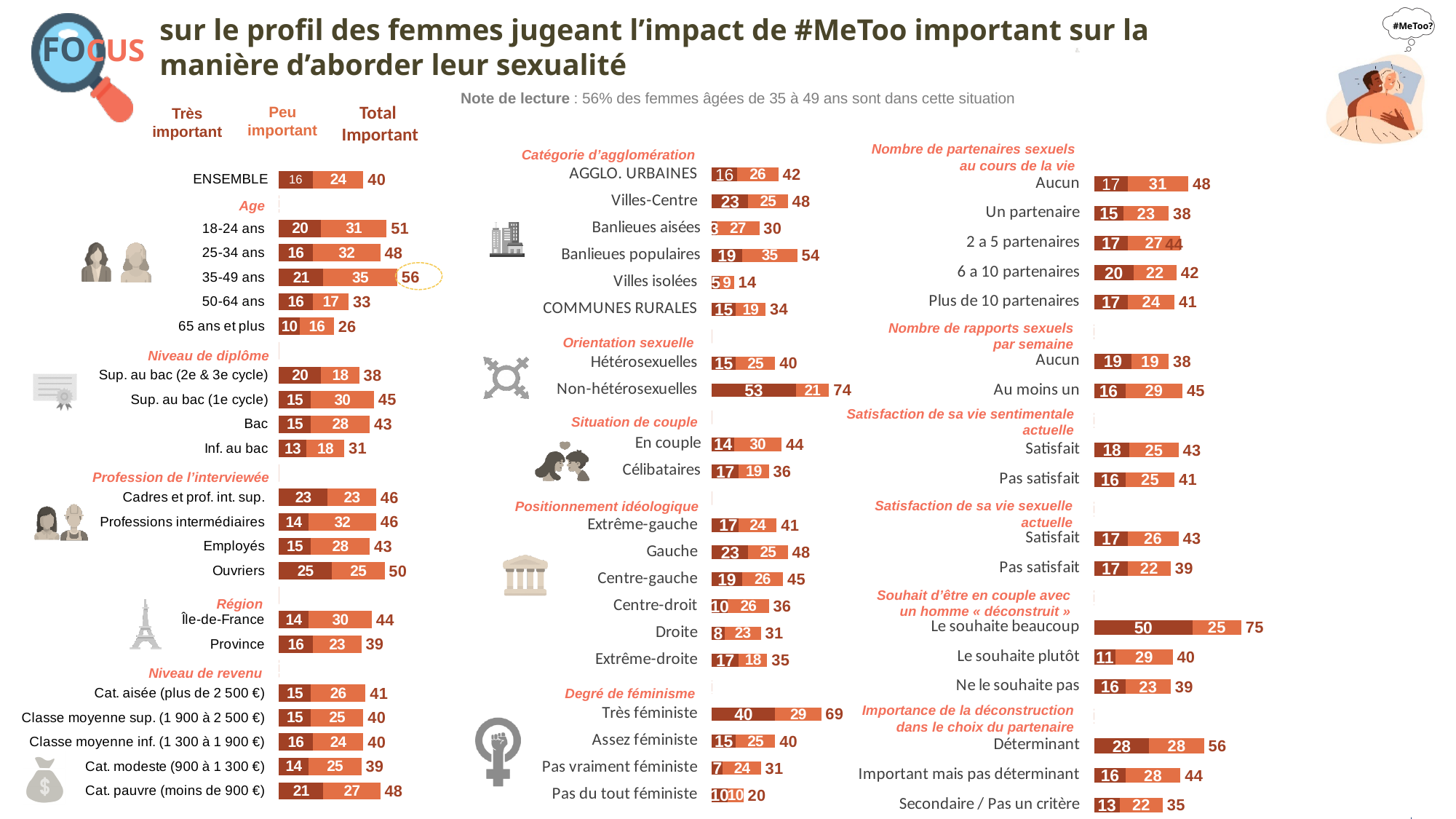
In the Région section, what is the difference between the Total Important values for Île-de-France and Province? 5 How many categories are plotted in the Positionnement idéologique section? 6 In the section 'Souhait d'être en couple avec un homme « déconstruit »', what is the total of the stacked bar for 'Le souhaite beaucoup'? 75 In the Age section, what is the Total Important value for 35-49 ans? 56 In the Orientation sexuelle section, what is the Très important value for Non-hétérosexuelles? 53 In the Orientation sexuelle section, what is the difference between the Total Important values for Non-hétérosexuelles and Hétérosexuelles? 34 In the Degré de féminisme section, which category has the lowest Total Important value? Pas du tout féministe In the Degré de féminisme section, which has the larger Total Important value: Très féministe or Assez féministe? Très féministe In the Age section, which age group has the highest Total Important value? 35-49 ans In the Catégorie d'agglomération section, what is the Peu important value for Villes isolées? 9 What kind of chart is used on this slide to show the values? Bar chart How many stacked segments (series) make up each bar, according to the column headers at the top left? 2